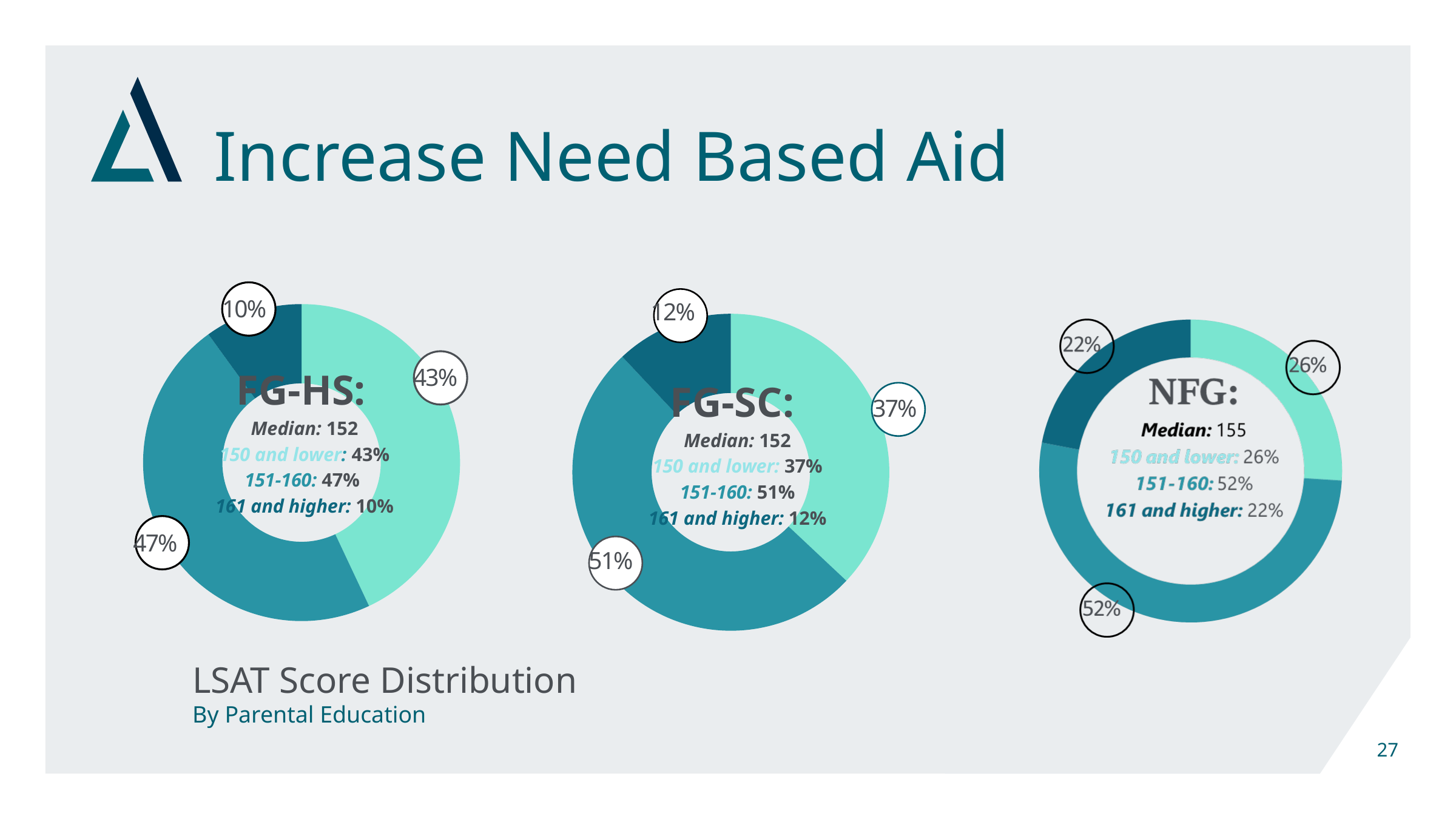
In the FG-HS chart, what share of students scored 150 and lower on the LSAT? 43% What is the difference between the 151-160 share and the 150 and lower share in the FG-SC chart? 14% In the FG-HS chart, which LSAT score range has the largest share? 151-160 Which is larger in the NFG chart: the share for 150 and lower or the share for 161 and higher? 150 and lower What is the median LSAT score shown in the NFG chart? 155 How many LSAT score ranges does each donut chart show? 3 In the NFG chart, which LSAT score range has the largest share? 151-160 In the FG-SC chart, which LSAT score range has the smallest share? 161 and higher What is the title of the chart group at the bottom left of the slide? LSAT Score Distribution In the NFG chart, what share of students scored 161 and higher? 22% What type of chart is used for the FG-HS, FG-SC and NFG groups? Donut (pie) chart In the FG-SC chart, what share of students scored 151-160? 51%